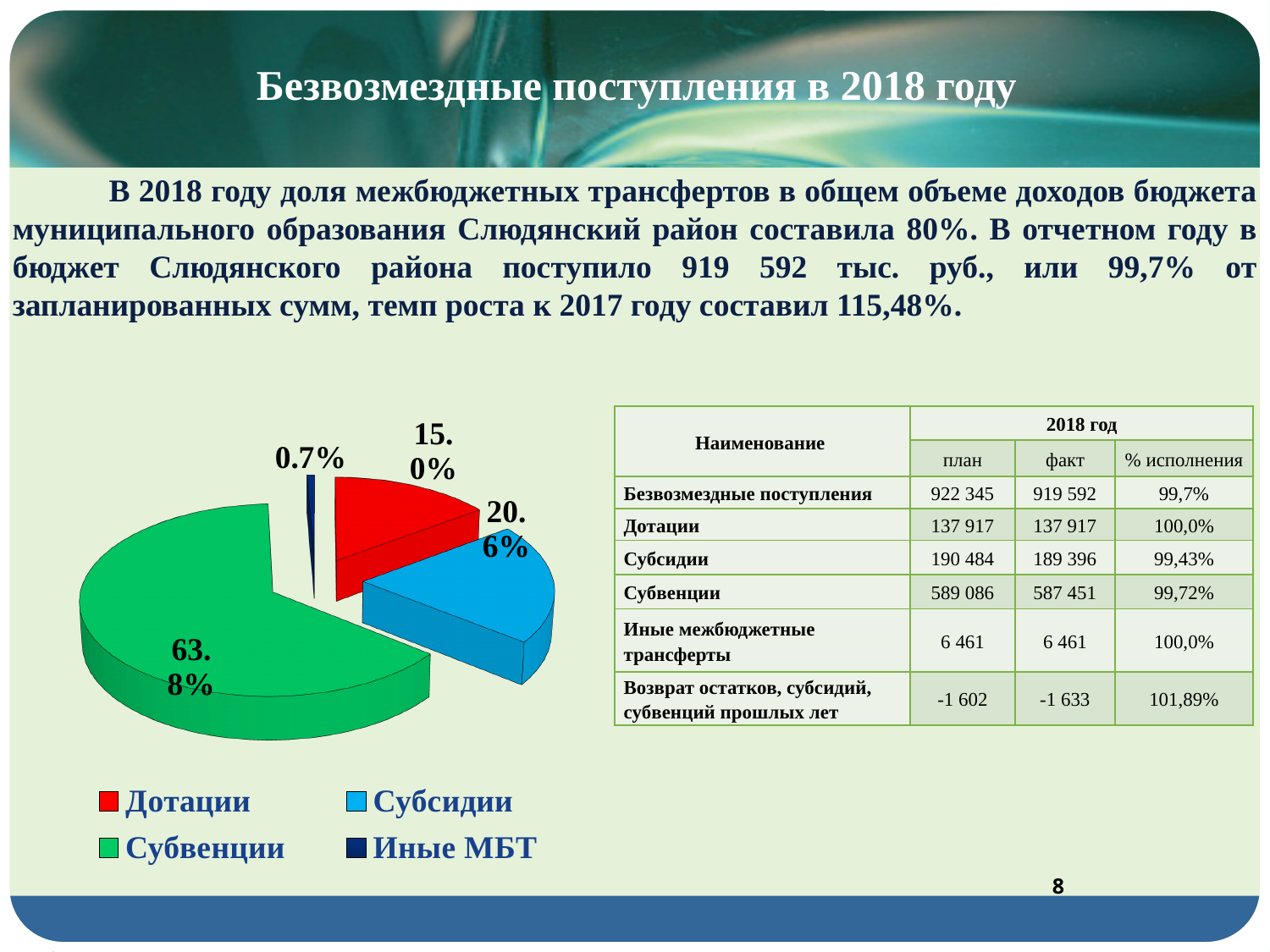
What share of the pie chart does Субсидии represent? 20.6% Which category has the smallest slice in the pie chart? Иные МБТ What kind of chart is shown on the slide? Pie chart What colour is the Субвенции slice in the pie chart? Green What share of the pie chart does Дотации represent? 15.0% Which category has the largest slice in the pie chart? Субвенции How many slices does the pie chart have? 4 How many entries does the legend of the pie chart list? 4 Which slice is larger in the pie chart, Дотации or Субсидии? Субсидии What share of the pie chart does Иные МБТ represent? 0.7% What share of the pie chart does Субвенции represent? 63.8% By how many percentage points does the Субвенции slice exceed the Дотации slice? 48.8